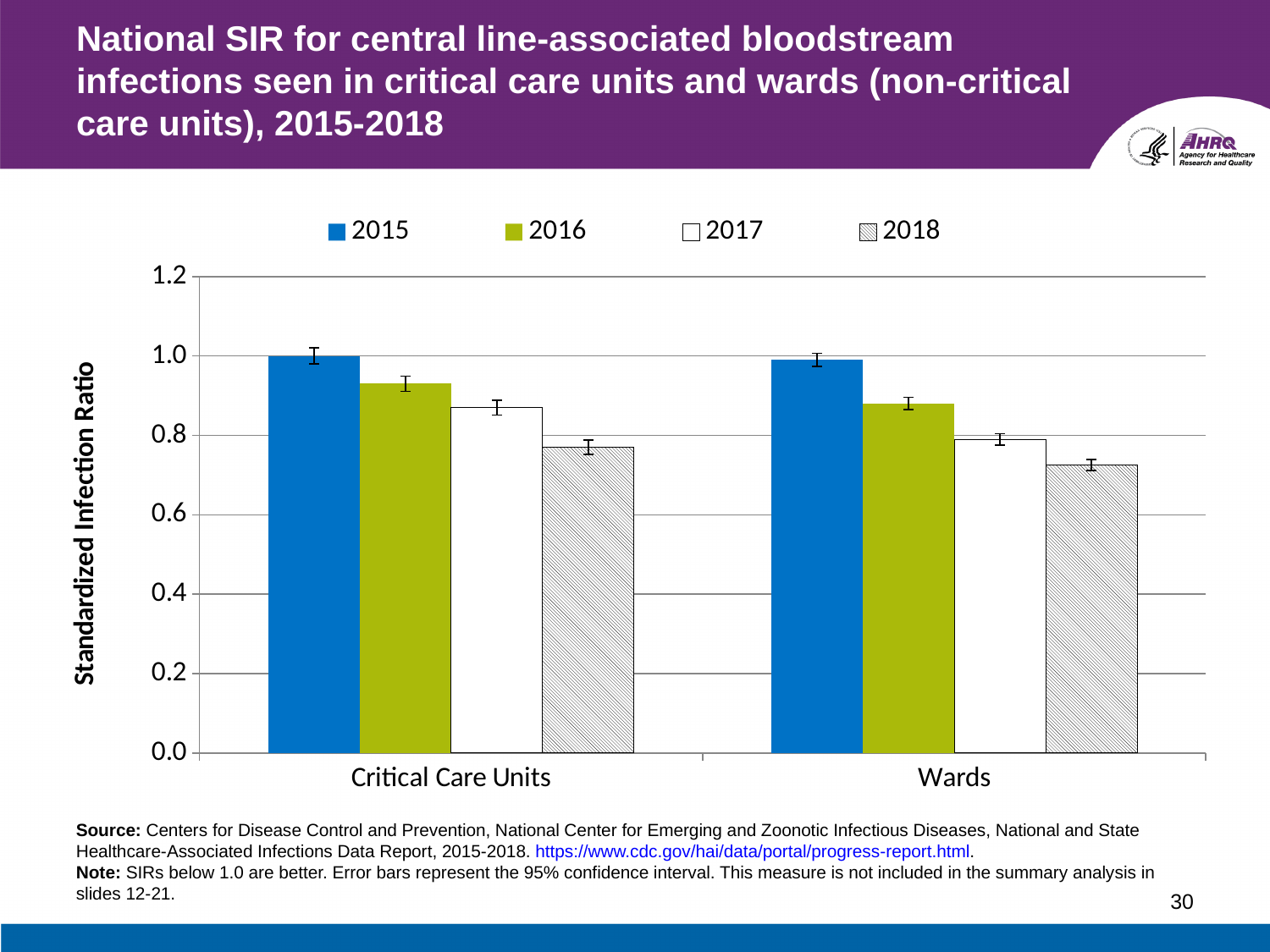
What is the title of the y axis? Standardized Infection Ratio For Wards, which is larger: the 2016 value or the 2018 value? 2016 How many categories are shown on the x axis? 2 Is the 2018 value for Wards greater or less than 0.8? less Which year has the highest Standardized Infection Ratio for Critical Care Units? 2015 What kind of chart is shown on the slide? bar chart Which year has the lowest Standardized Infection Ratio for Wards? 2018 Do the values for Critical Care Units rise or fall from 2015 to 2018? fall Is the 2016 value for Wards greater or less than 0.8? greater Is the 2018 value for Critical Care Units greater or less than 0.8? less How many series does the legend list? 4